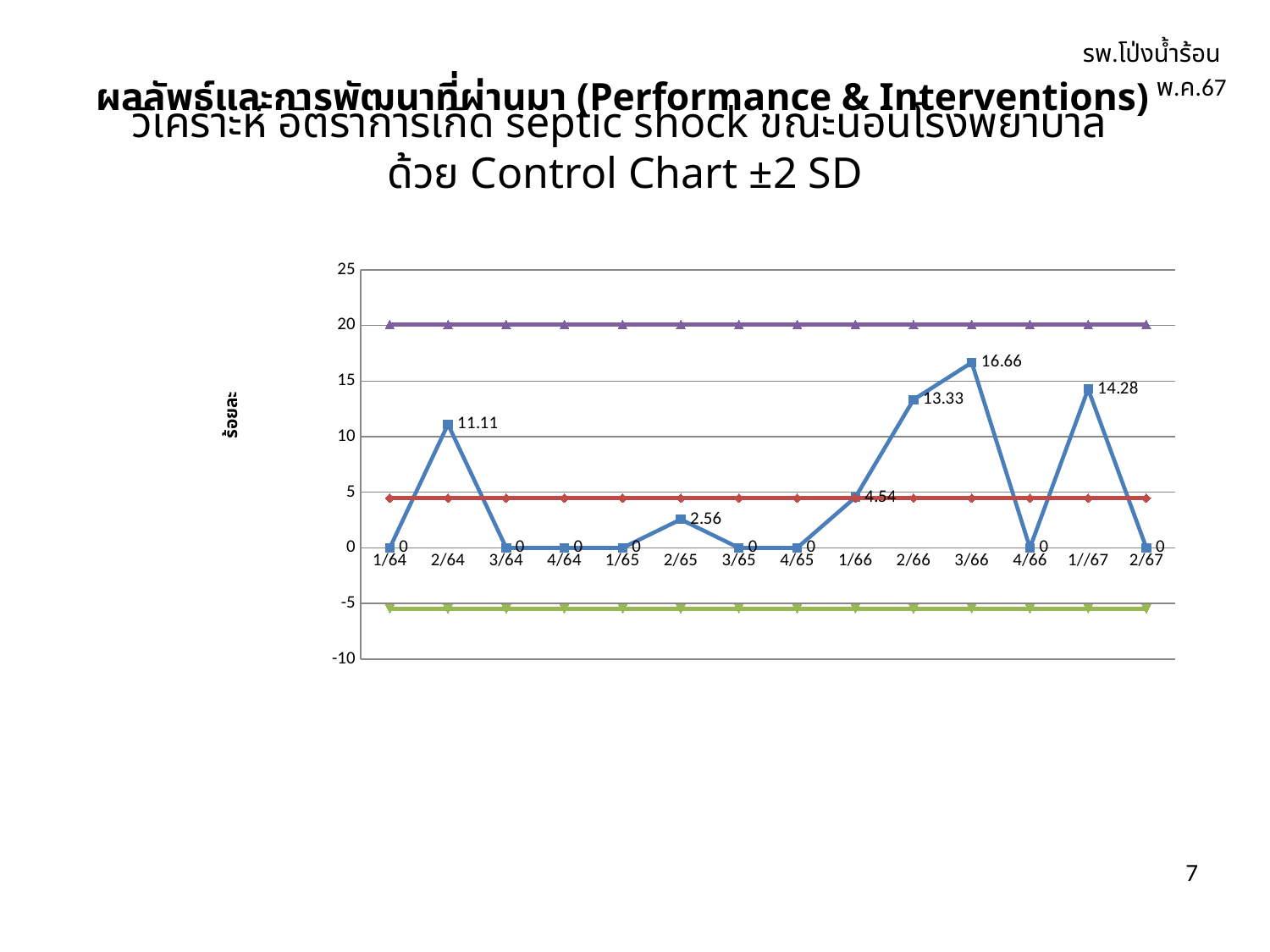
What is the label on the vertical axis of the chart? ร้อยละ What is the value for 2/65 on the chart? 2.56 How many periods are shown on the x axis of the chart? 14 Do the values rise or fall from 1/66 to 3/66? rise Is the flat upper line (purple) greater or less than 15? greater What kind of chart is shown on the slide? line chart Which period has the highest value on the chart? 3/66 What is the value for 3/66 on the chart? 16.66 Which is larger, the value for 2/64 or the value for 1//67? 1//67 What is the value for 2/64 on the chart? 11.11 What is the difference between the values for 3/66 and 2/66? 3.33 What is the value for 1//67 on the chart? 14.28